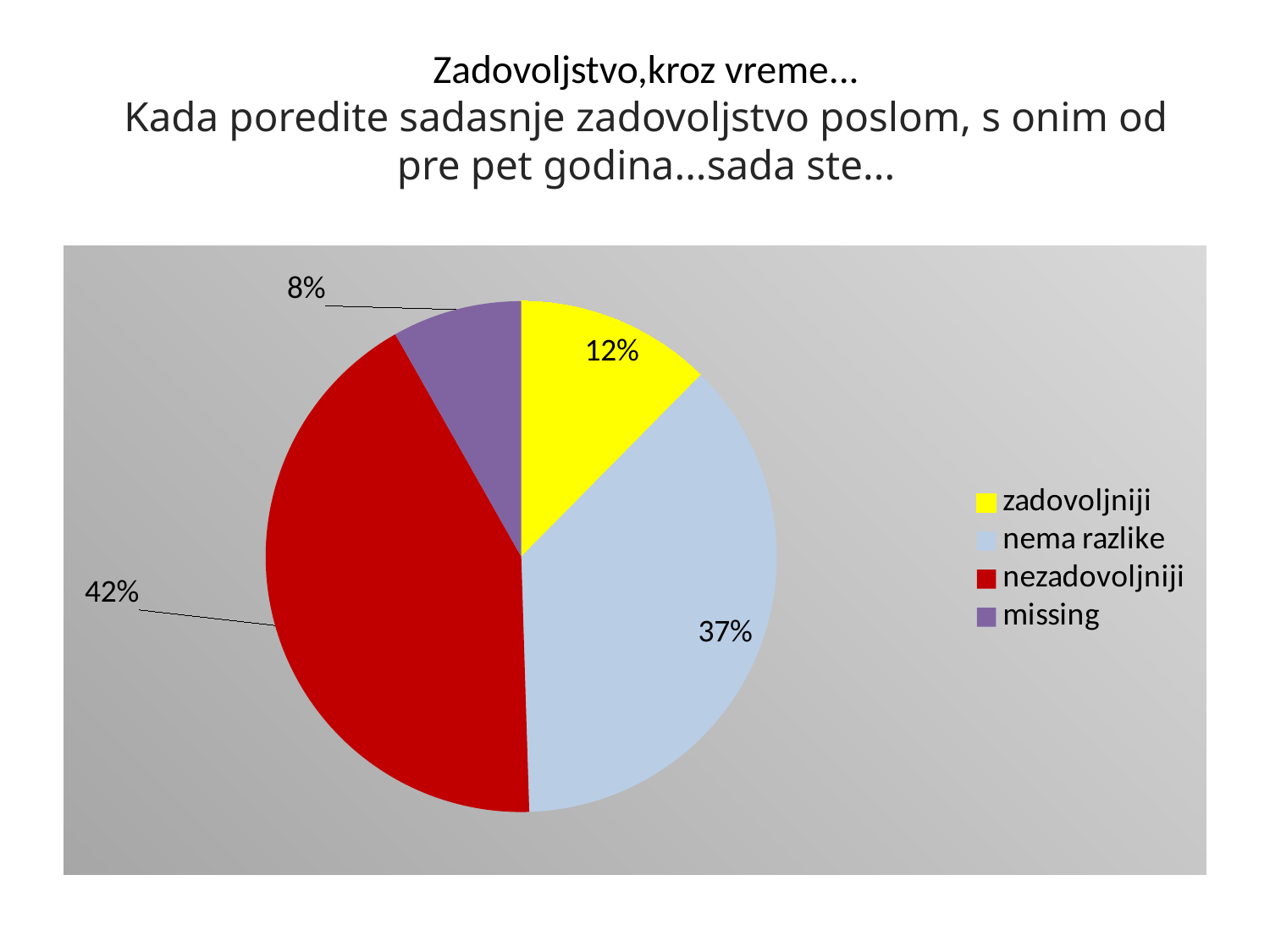
Which category is shown in yellow in the legend? zadovoljniji What is the difference in percentage points between "nezadovoljniji" and "nema razlike"? 5 How many categories does the pie chart show? 4 What percentage of the pie is labelled "nezadovoljniji"? 42% Which category has the smallest slice of the pie? missing What percentage of the pie is labelled "nema razlike"? 37% Which is larger, the slice for "zadovoljniji" or the slice for "missing"? zadovoljniji What colour is the slice for "nezadovoljniji"? red What percentage of the pie is labelled "missing"? 8% What kind of chart is shown on the slide? pie chart Which category has the largest slice of the pie? nezadovoljniji What percentage of the pie is labelled "zadovoljniji"? 12%